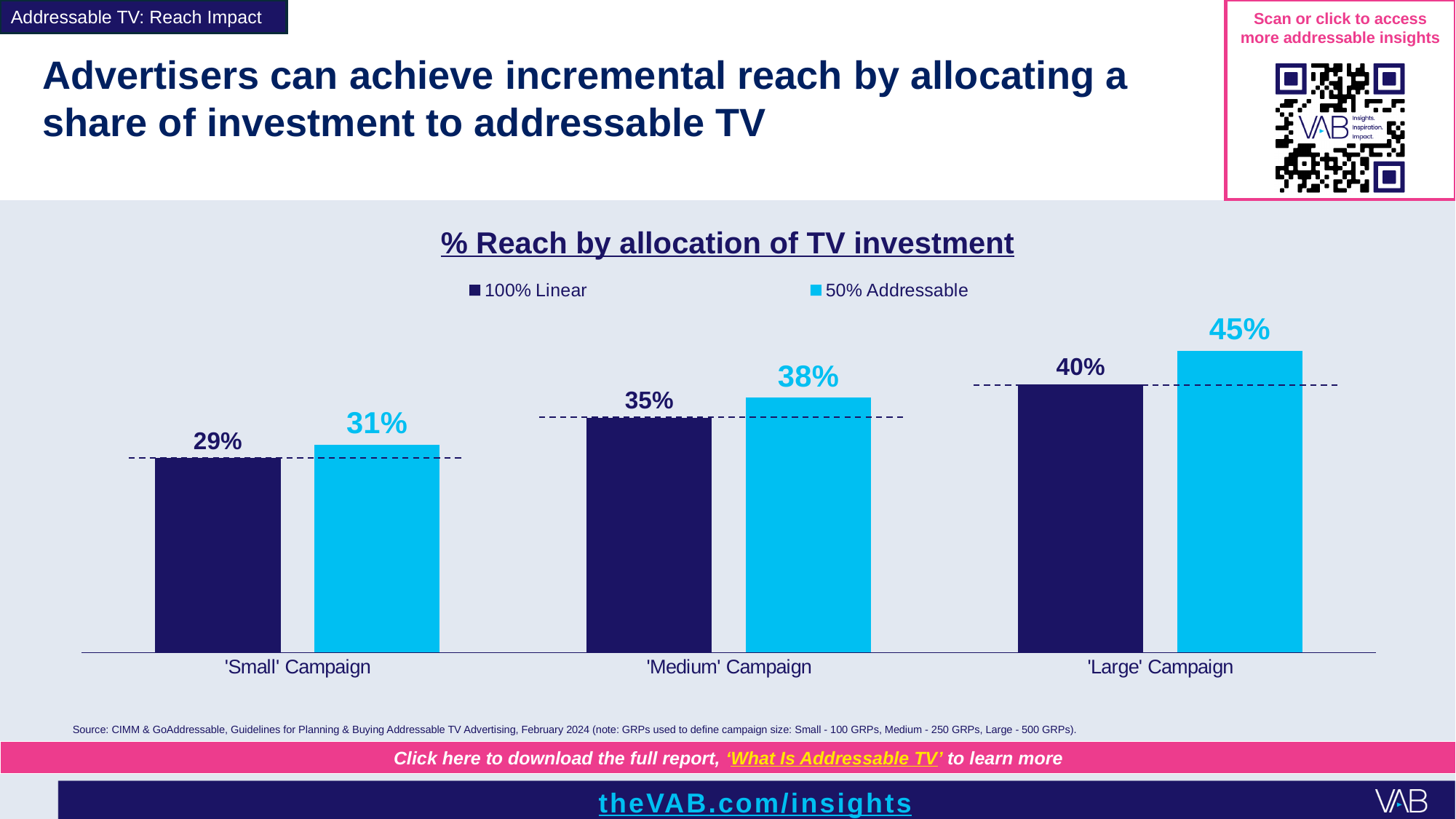
What is the difference between the 50% Addressable and 100% Linear reach in the 'Medium' Campaign? 3% In the 'Small' Campaign, which series has the higher % reach: 100% Linear or 50% Addressable? 50% Addressable What is the % reach for the 100% Linear series in the 'Small' Campaign? 29% Which campaign size has the lowest % reach for the 100% Linear series? 'Small' Campaign Which campaign size has the highest % reach for the 50% Addressable series? 'Large' Campaign What is the % reach for the 50% Addressable series in the 'Medium' Campaign? 38% How many campaign size categories are shown on the x axis? 3 What kind of chart is shown on the slide? Bar chart What is the % reach for the 50% Addressable series in the 'Large' Campaign? 45% How many series does the legend list? 2 What is the difference between the 50% Addressable and 100% Linear reach in the 'Large' Campaign? 5% Does the % reach for the 100% Linear series rise or fall from 'Small' Campaign to 'Large' Campaign? Rise